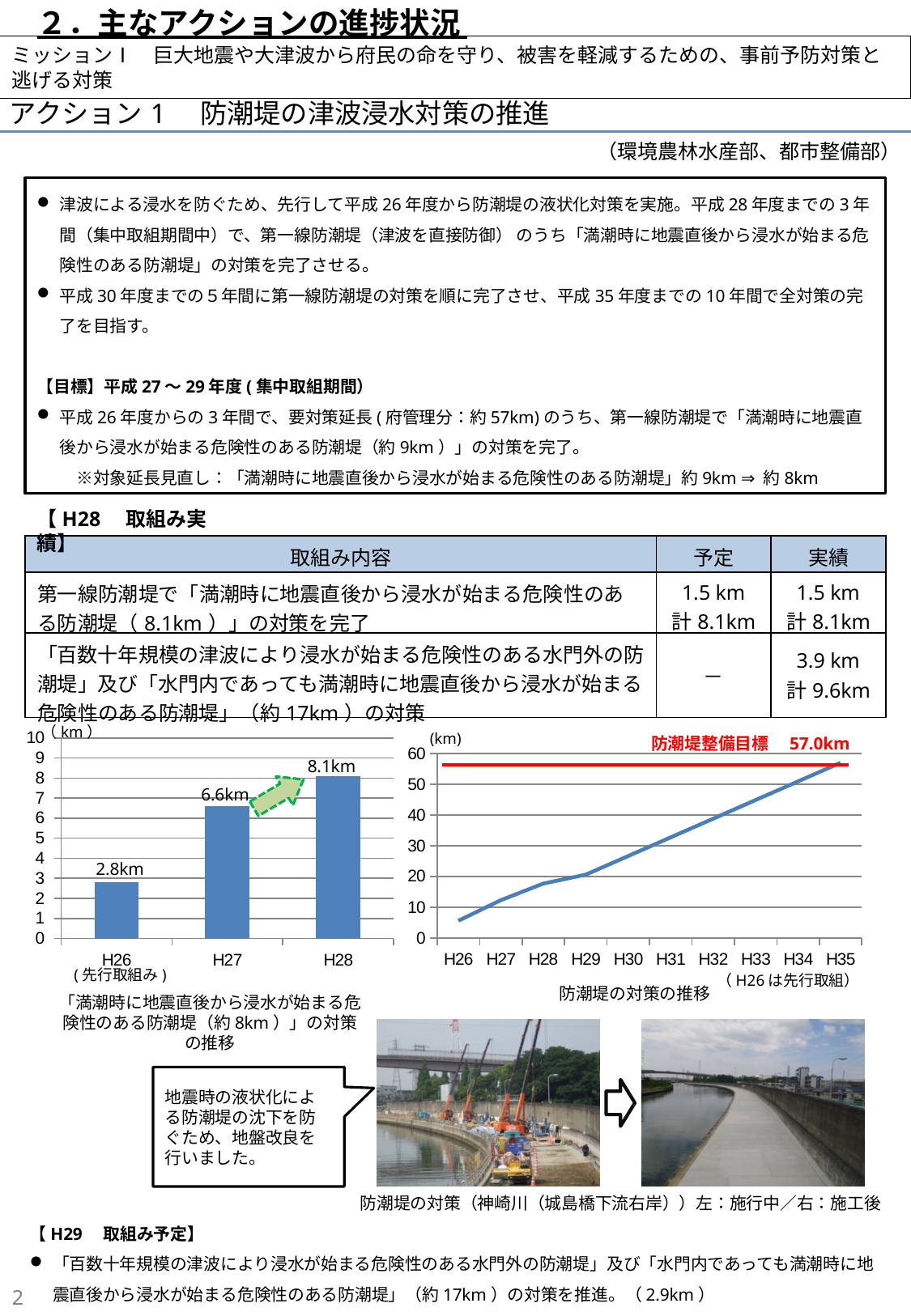
In the left bar chart, what is the difference between the H28 and H26 values? 5.3km In the left bar chart, what is the value for H28? 8.1km In the right line chart (防潮堤の対策の推移), is the value for H29 greater or less than 30? less In the left bar chart, which year has the lowest value? H26 In the right line chart (防潮堤の対策の推移), what target value (防潮堤整備目標) is shown by the red line? 57.0km In the left bar chart, what is the value for H26? 2.8km What kind of chart is the left chart on the slide? bar chart In the left bar chart, what is the value for H27? 6.6km In the left bar chart, what is the difference between the H28 and H27 values? 1.5km In the left bar chart, which year has the highest value? H28 In the left bar chart, how many bars are plotted? 3 In the right line chart (防潮堤の対策の推移), how many years are shown on the x axis? 10